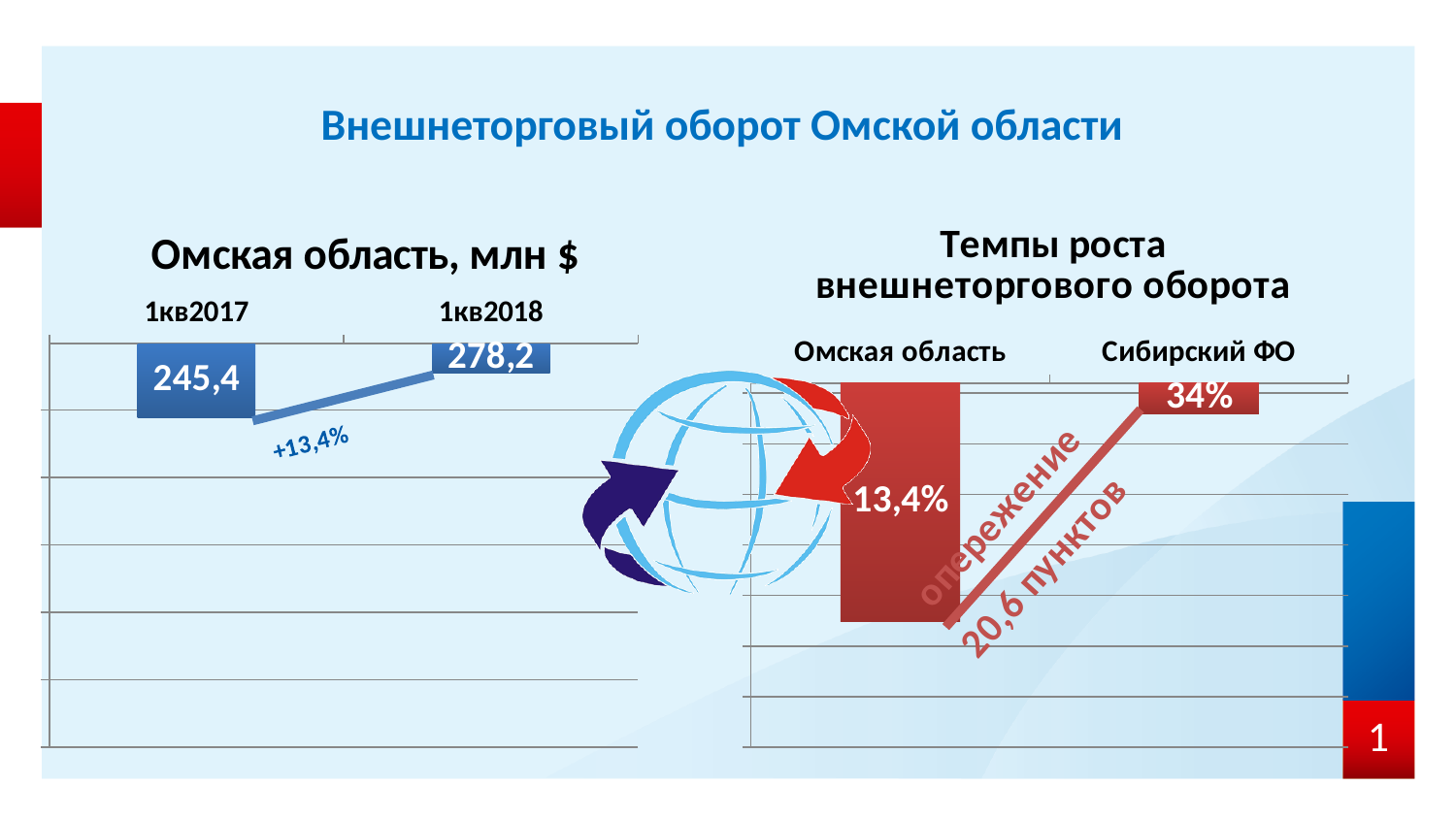
On the chart titled "Темпы роста внешнеторгового оборота", what is the value for Омская область? 13,4% On the chart titled "Омская область, млн $", what is the value for 1кв2018? 278,2 On the chart titled "Омская область, млн $", how many periods are plotted? 2 On the chart titled "Омская область, млн $", what is the difference between the 1кв2018 and 1кв2017 values? 32,8 On the chart titled "Темпы роста внешнеторгового оборота", by how many points does Сибирский ФО exceed Омская область? 20,6 пунктов On the chart titled "Омская область, млн $", what percentage change is shown between 1кв2017 and 1кв2018? +13,4% On the chart titled "Омская область, млн $", what is the value for 1кв2017? 245,4 On the chart titled "Темпы роста внешнеторгового оборота", which category has the higher growth rate? Сибирский ФО On the chart titled "Омская область, млн $", which period has the higher value? 1кв2018 What is the title of the slide? Внешнеторговый оборот Омской области What kind of chart is the one titled "Темпы роста внешнеторгового оборота"? bar chart On the chart titled "Темпы роста внешнеторгового оборота", what is the value for Сибирский ФО? 34%